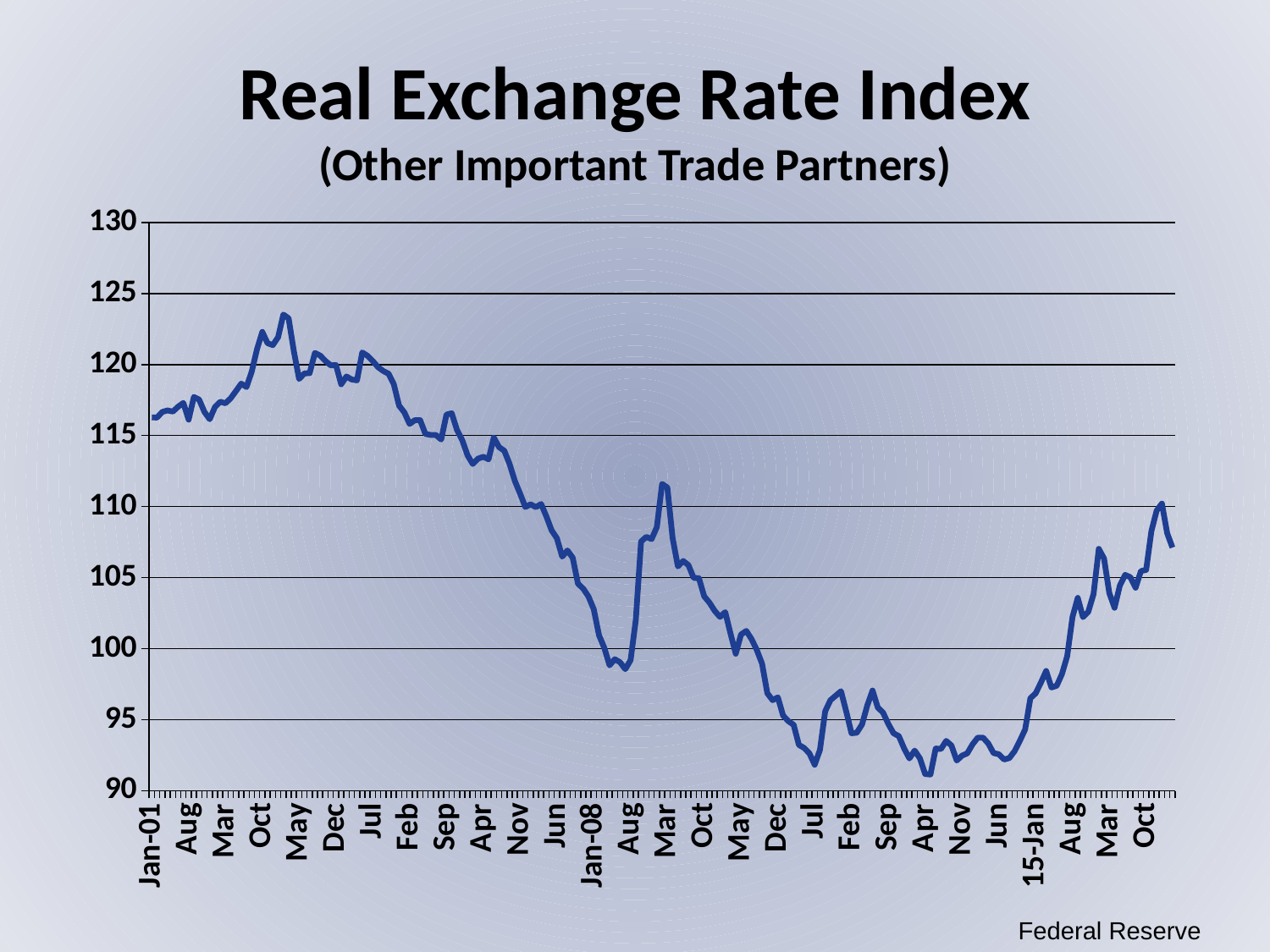
How many data series are plotted on the chart? 1 Is the value at Jan-01 greater or less than 110? greater What source is cited at the bottom of the slide? Federal Reserve Is the value at Jan-08 greater or less than 105? less Is the lowest point on the line greater or less than 95? less What kind of chart is shown on the slide? line chart Does the index generally rise or fall from 15-Jan to the end of the series? rise Which is larger, the value at Jan-01 or the value at Jan-08? Jan-01 What is the title of the chart? Real Exchange Rate Index (Other Important Trade Partners) Does the index generally rise or fall between Jan-01 and Jan-08? fall